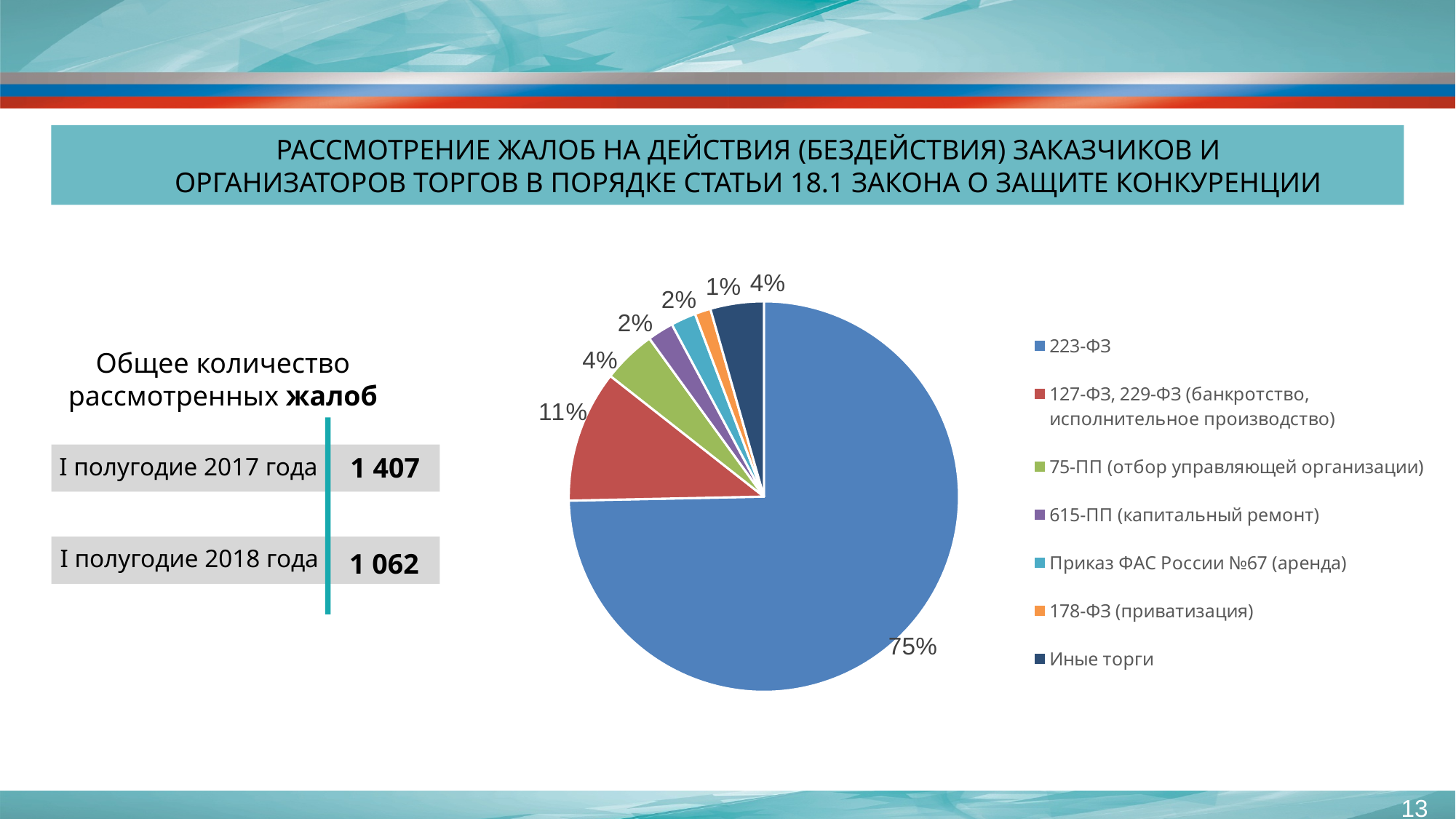
What share of the pie does 223-ФЗ account for? 75% What is the difference between the share for 223-ФЗ and the share for 127-ФЗ, 229-ФЗ? 64% How many slices does the pie chart have? 7 Which category has the largest slice of the pie? 223-ФЗ What is the value for Иные торги? 4% What kind of chart is shown on the slide? pie chart Which category has the smallest slice of the pie? 178-ФЗ (приватизация) What is the value for 127-ФЗ, 229-ФЗ (банкротство, исполнительное производство)? 11% What is the value for 75-ПП (отбор управляющей организации)? 4% What colour is the slice for 223-ФЗ? blue What is the value for 178-ФЗ (приватизация)? 1% Which is larger: the share for 75-ПП (отбор управляющей организации) or the share for 615-ПП (капитальный ремонт)? 75-ПП (отбор управляющей организации)